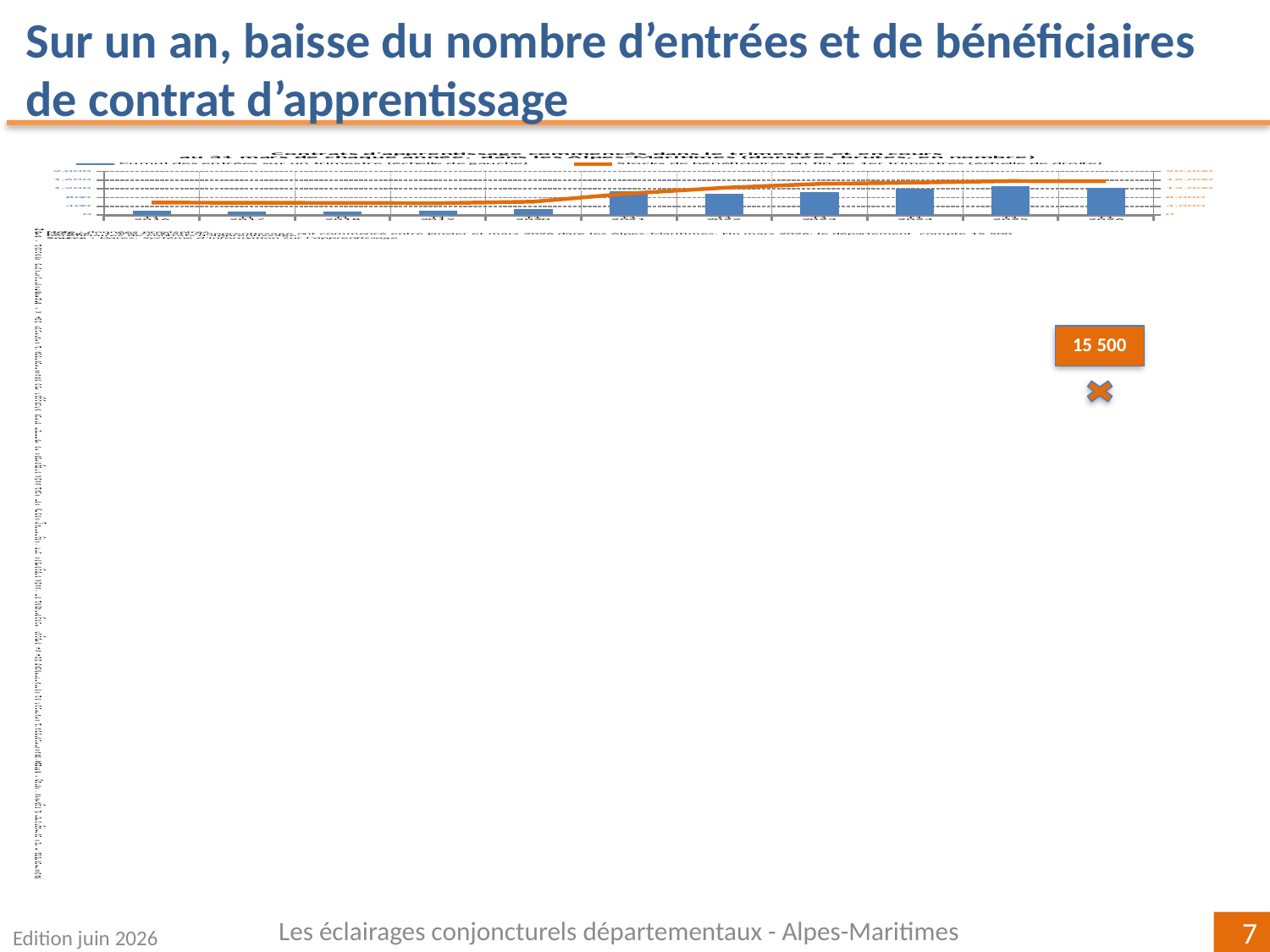
Do the bar values generally rise or fall from left to right along the x axis? Rise Is the first bar on the left larger or smaller than the last bar on the right? Smaller Does the orange line generally rise or fall from left to right across the chart? Rise What kind of chart is shown on the slide? A bar chart combined with a line What colour is the line series in the chart? Orange How many series does the chart's legend list? 2 What colour are the bars in the chart? Blue How many bars are plotted in the chart? 11